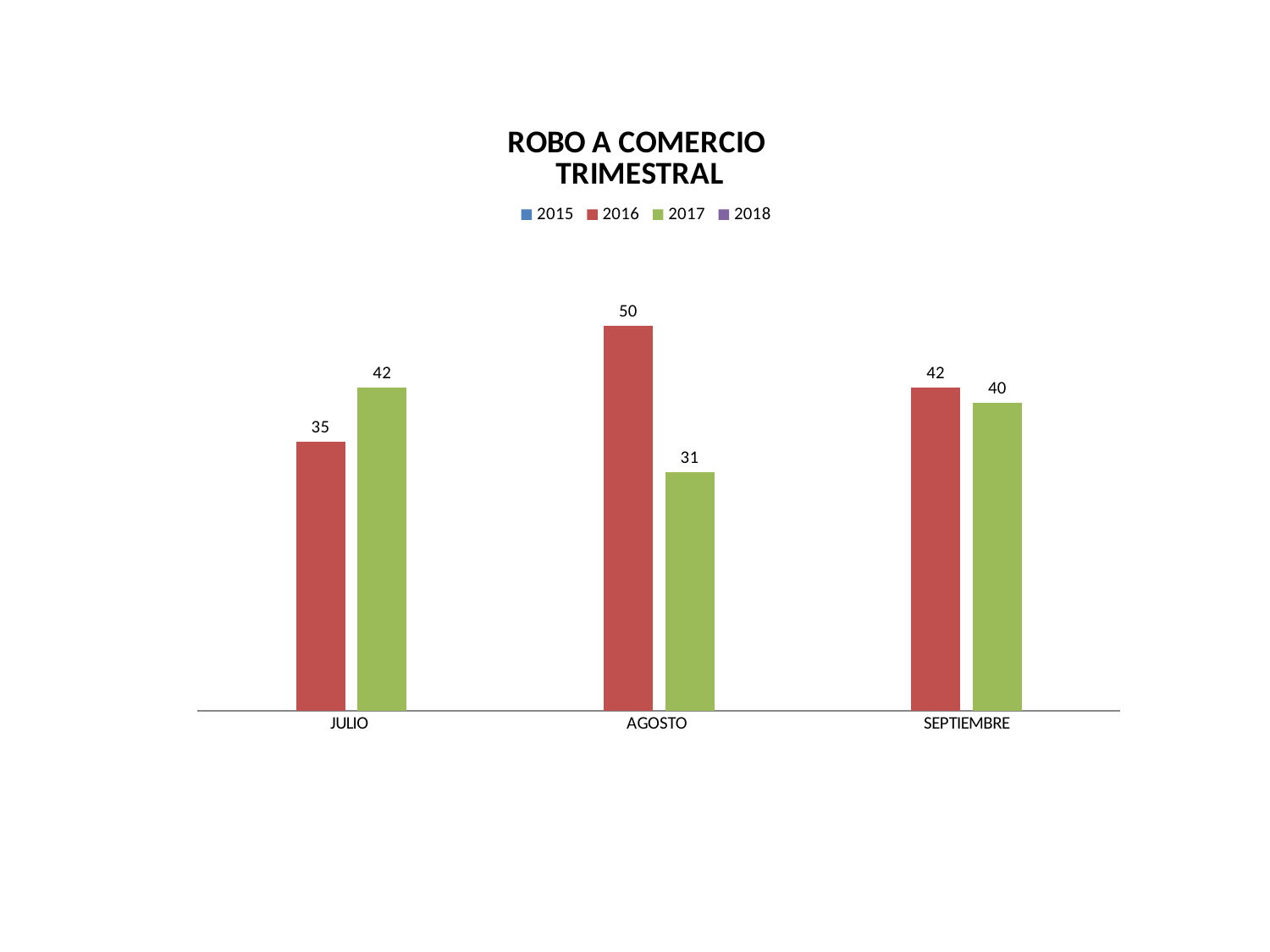
What is the value for 2017 in SEPTIEMBRE? 40 In which month is the 2017 value lowest? AGOSTO What is the value for 2016 in AGOSTO? 50 What is the difference between the 2016 and 2017 values in AGOSTO? 19 What is the title of the chart? ROBO A COMERCIO TRIMESTRAL How many months are shown on the x axis? 3 What is the value for 2017 in JULIO? 42 Which is larger in JULIO, the 2016 value or the 2017 value? 2017 In which month is the 2016 value highest? AGOSTO How many series does the legend list? 4 What is the value for 2016 in JULIO? 35 What kind of chart is shown? bar chart